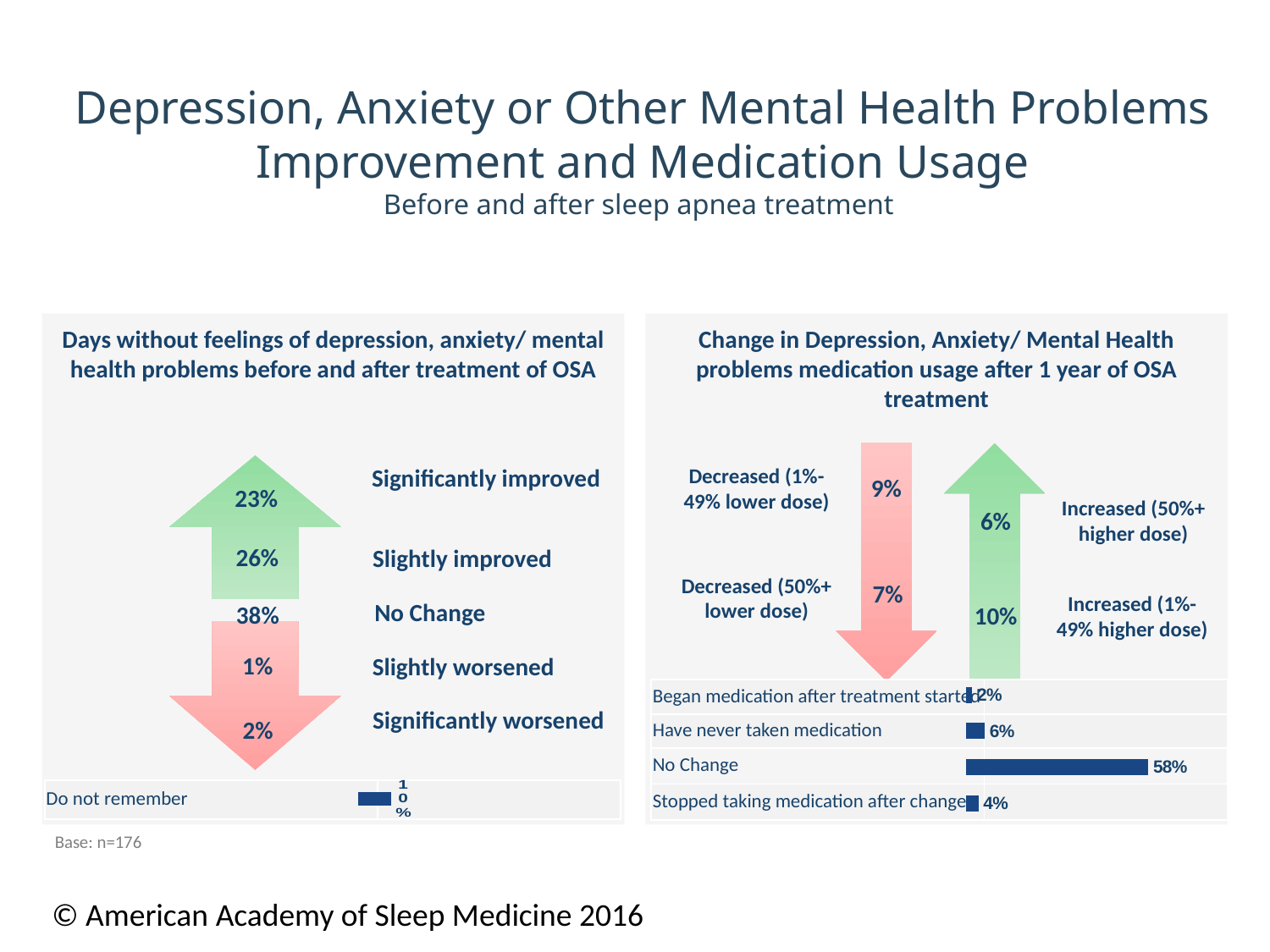
In the right-hand chart on medication usage, which bar category has the lowest value? Began medication after treatment started In the left-hand chart on days without feelings of depression, what percentage is shown for "No Change"? 38% In the right-hand chart on medication usage, what is the difference between "No Change" and "Have never taken medication"? 52% In the right-hand chart on medication usage, what percentage is shown for "Increased (1%-49% higher dose)"? 10% In the right-hand chart on medication usage, what is the value for "Have never taken medication"? 6% In the left-hand chart on days without feelings of depression, which is larger: "Significantly improved" or "Slightly improved"? Slightly improved In the right-hand chart on medication usage, how many bar categories are shown? 4 In the left-hand chart on days without feelings of depression, what is the value for "Do not remember"? 10% What type of chart is used for the "Do not remember" value in the left-hand panel? bar chart In the right-hand chart on medication usage, what is the value for "Stopped taking medication after change"? 4% In the right-hand chart on medication usage, what is the value for "No Change"? 58% In the right-hand chart on medication usage, which bar category has the highest value? No Change